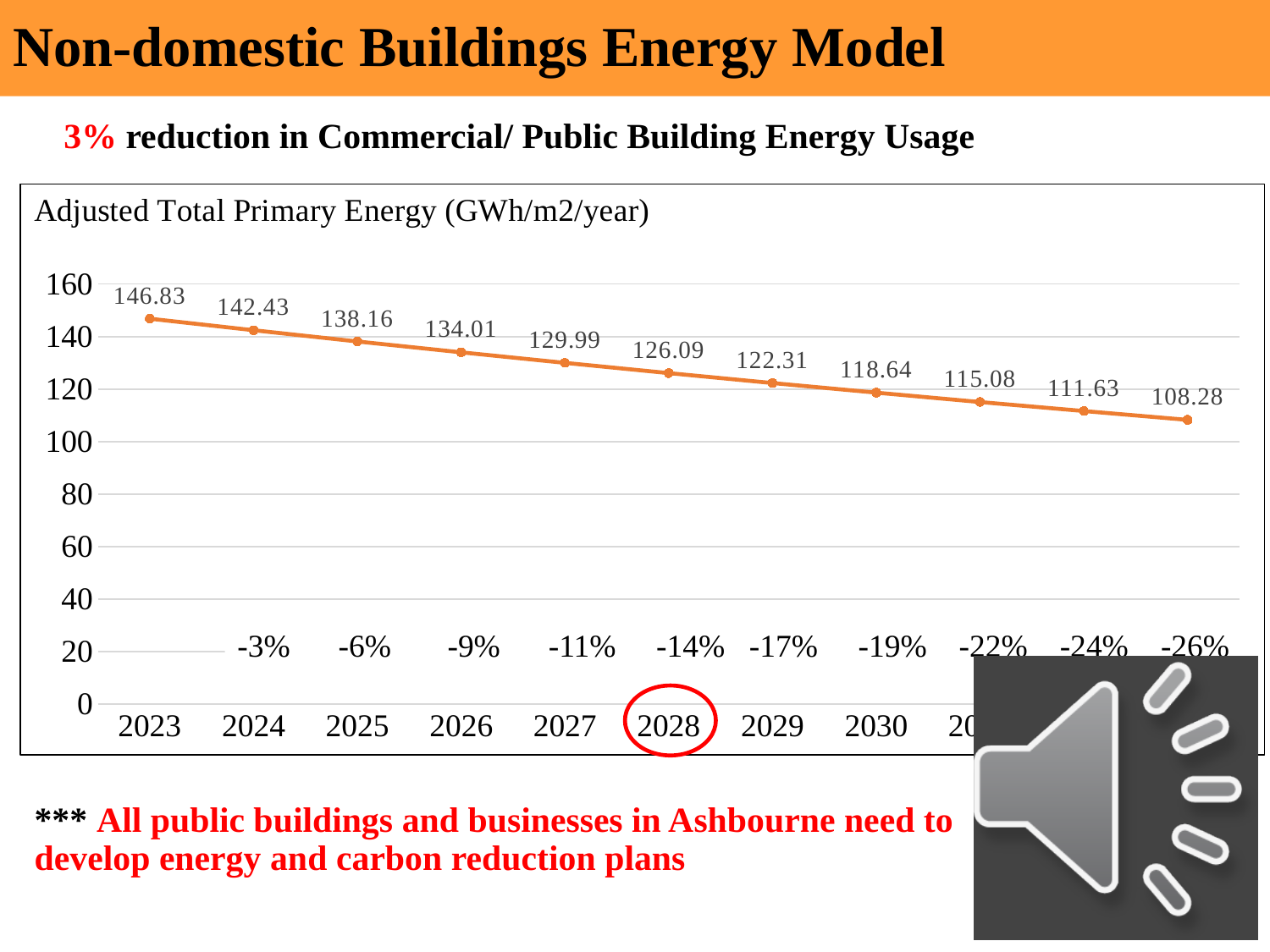
How many data points are plotted on the line? 11 Do the values rise or fall from left to right along the x axis? fall What is the Adjusted Total Primary Energy value for 2028? 126.09 What is the difference between the values for 2023 and 2024? 4.40 What kind of chart is shown on the slide? line chart What is the Adjusted Total Primary Energy value for 2023? 146.83 What is the Adjusted Total Primary Energy value for 2030? 118.64 What is the lowest value plotted on the chart? 108.28 Which year has the highest Adjusted Total Primary Energy value? 2023 Is the value for 2027 greater or less than 120? greater Which is larger, the value for 2025 or the value for 2029? 2025 What percentage reduction label is shown for 2028? -14%